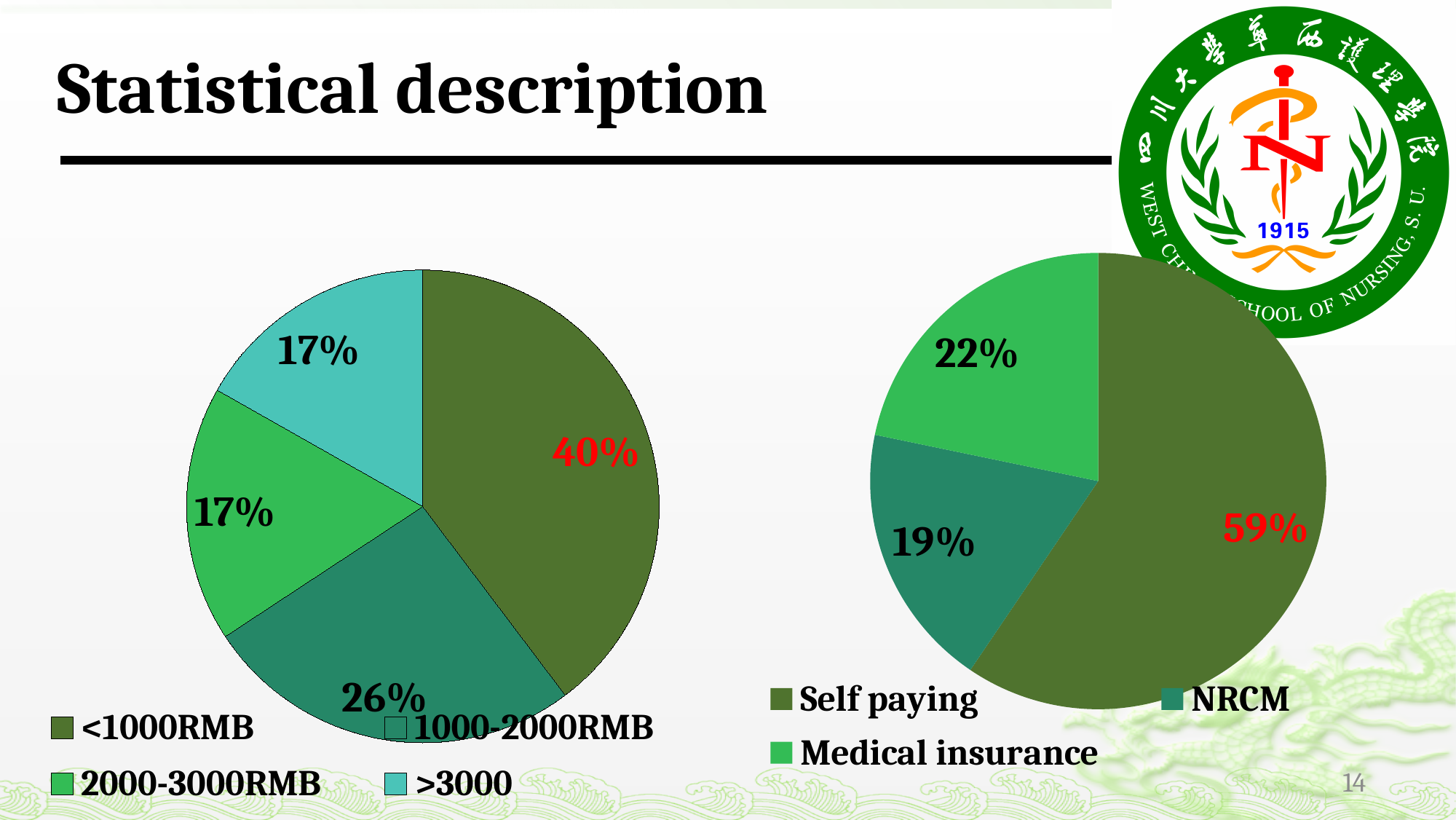
On the left pie chart, what share is labelled for the <1000RMB slice? 40% On the right pie chart, how many categories does the legend list? 3 On the right pie chart, what share is labelled for Self paying? 59% On the left pie chart, what share is labelled for the 1000-2000RMB slice? 26% On the right pie chart, which category has the smallest slice? NRCM On the left pie chart, what is the difference between the <1000RMB share and the 1000-2000RMB share? 14% On the right pie chart, which is larger, Medical insurance or NRCM? Medical insurance On the left pie chart, which category has the largest slice? <1000RMB What type of chart is shown on the left of the slide? Pie chart On the right pie chart, what share is labelled for NRCM? 19% On the left pie chart, how many slices are there? 4 On the right pie chart, what share is labelled for Medical insurance? 22%